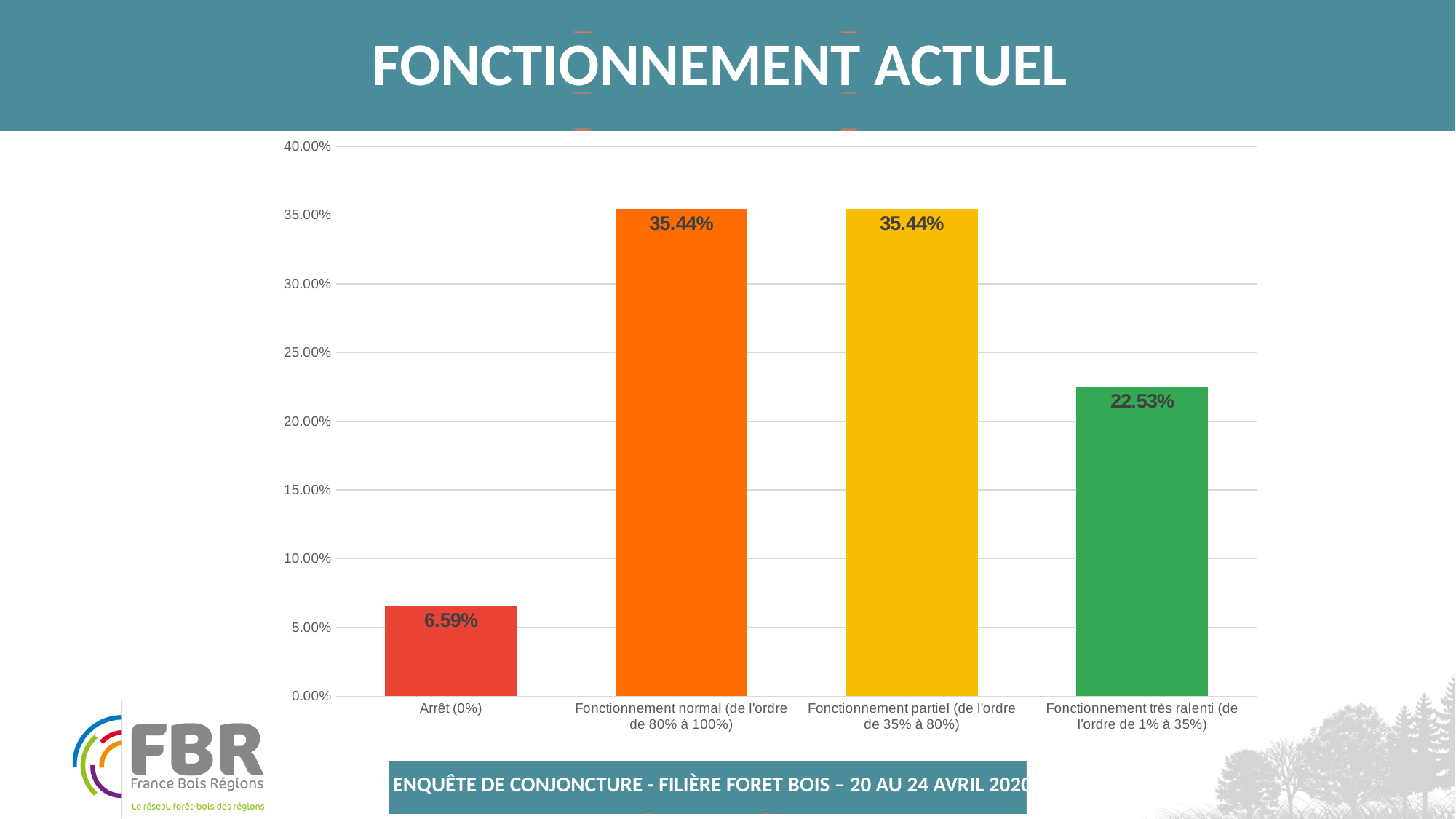
What is the difference between the values for Fonctionnement normal and Fonctionnement très ralenti? 12.91% What is the value for Fonctionnement normal (de l'ordre de 80% à 100%)? 35.44% Is the value for Fonctionnement partiel greater or less than 30.00%? greater How many categories are shown on the chart? 4 What is the difference between the values for Fonctionnement très ralenti and Arrêt (0%)? 15.94% What is the value for Fonctionnement partiel (de l'ordre de 35% à 80%)? 35.44% What is the title of the slide containing the chart? FONCTIONNEMENT ACTUEL What is the value for Arrêt (0%)? 6.59% What kind of chart is shown on the slide? bar chart Which category has the lowest value? Arrêt (0%) What is the value for Fonctionnement très ralenti (de l'ordre de 1% à 35%)? 22.53% Which is larger, the value for Fonctionnement très ralenti or the value for Arrêt (0%)? Fonctionnement très ralenti